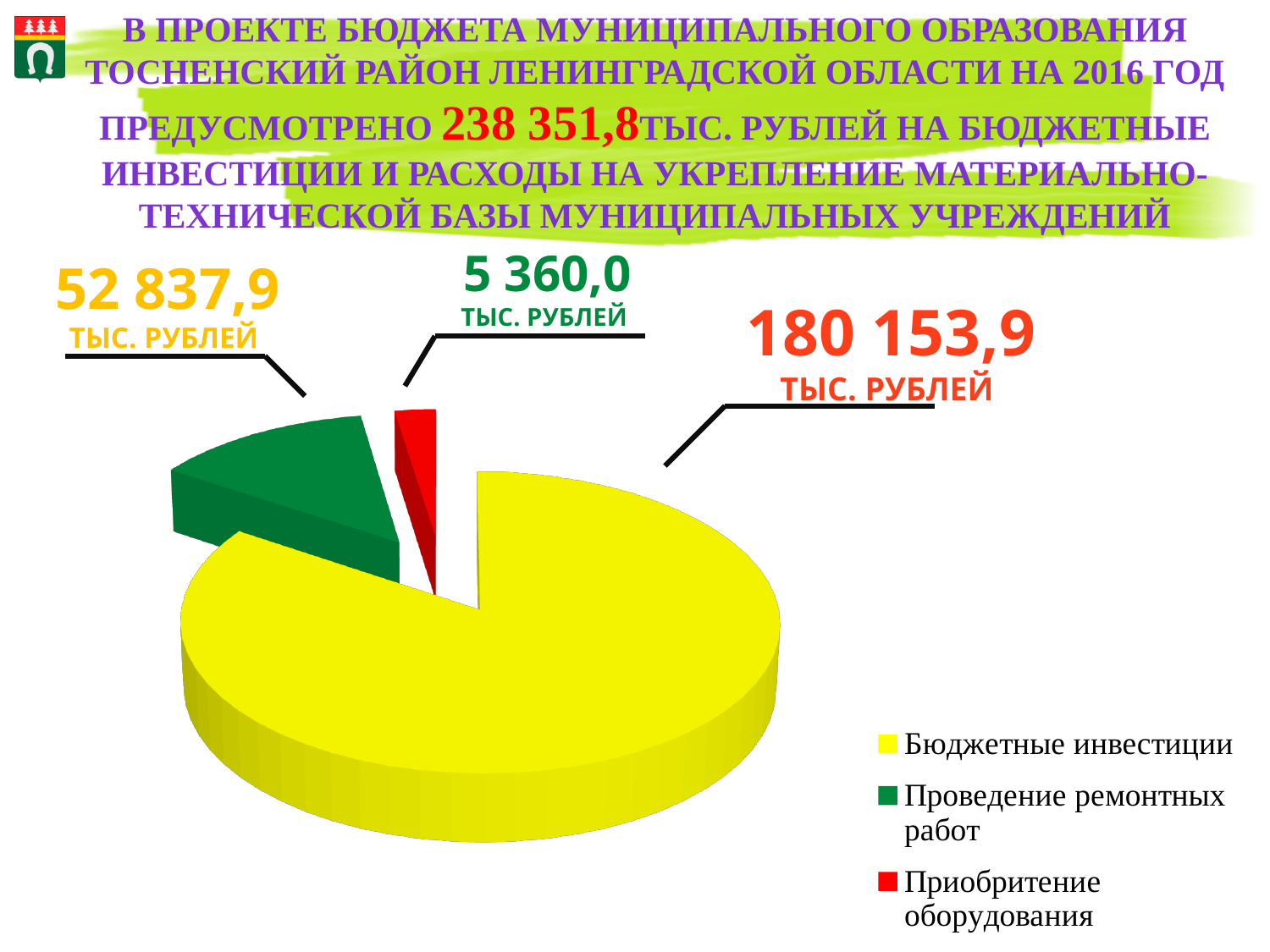
What colour is the slice for Проведение ремонтных работ? Green What is the total of all three slices of the pie? 238 351,8 тыс. рублей What is the value for Бюджетные инвестиции? 180 153,9 тыс. рублей How many slices does the pie chart have? 3 What is the value for Проведение ремонтных работ? 52 837,9 тыс. рублей Which is larger: Проведение ремонтных работ or Приобритение оборудования? Проведение ремонтных работ How many entries does the legend list? 3 Which category has the largest slice of the pie? Бюджетные инвестиции What type of chart is shown on the slide? Pie chart Which category has the smallest slice of the pie? Приобритение оборудования What is the value for Приобритение оборудования? 5 360,0 тыс. рублей What is the difference between Бюджетные инвестиции and Проведение ремонтных работ? 127 316,0 тыс. рублей